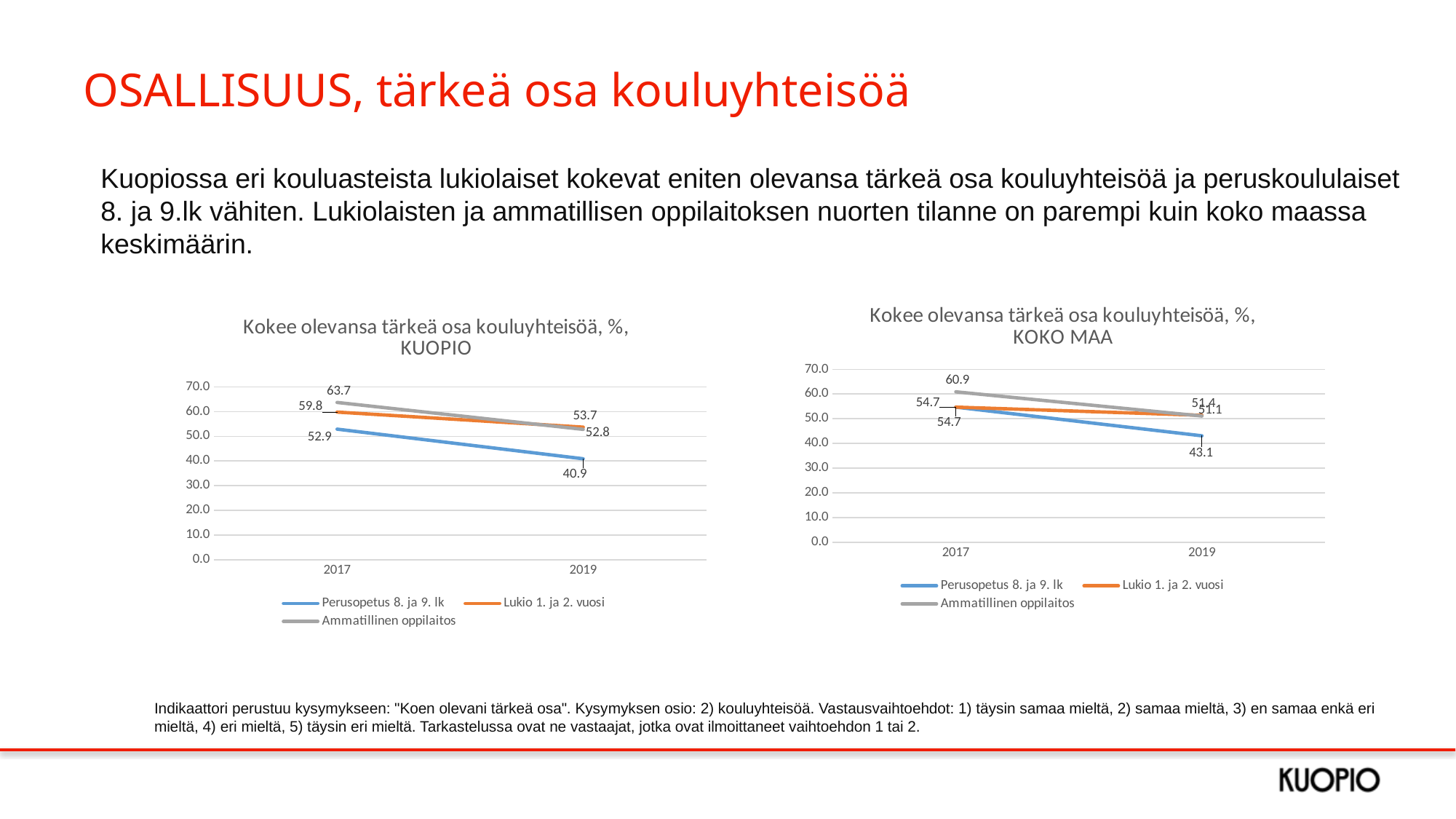
What kind of chart is the chart on the left of the slide? Line chart How many years are shown on the x axis of the KUOPIO chart on the left? 2 In the chart titled "Kokee olevansa tärkeä osa kouluyhteisöä, %, KUOPIO", what is the value for Lukio 1. ja 2. vuosi in 2019? 53.7 In the chart titled "Kokee olevansa tärkeä osa kouluyhteisöä, %, KUOPIO", what is the value for Ammatillinen oppilaitos in 2017? 63.7 How many series does the legend of the KUOPIO chart on the left list? 3 In the KOKO MAA chart on the right, does the value for Perusopetus 8. ja 9. lk rise or fall from 2017 to 2019? Fall In the KOKO MAA chart on the right, which series has the lowest value in 2019? Perusopetus 8. ja 9. lk In the chart titled "Kokee olevansa tärkeä osa kouluyhteisöä, %, KOKO MAA", what is the value for Perusopetus 8. ja 9. lk in 2019? 43.1 In the KUOPIO chart on the left, by how much did the value for Perusopetus 8. ja 9. lk fall from 2017 to 2019? 12.0 In the chart titled "Kokee olevansa tärkeä osa kouluyhteisöä, %, KUOPIO", what is the value for Perusopetus 8. ja 9. lk in 2019? 40.9 In the KUOPIO chart on the left, which series has the highest value in 2017? Ammatillinen oppilaitos In the chart titled "Kokee olevansa tärkeä osa kouluyhteisöä, %, KOKO MAA", what is the value for Ammatillinen oppilaitos in 2017? 60.9